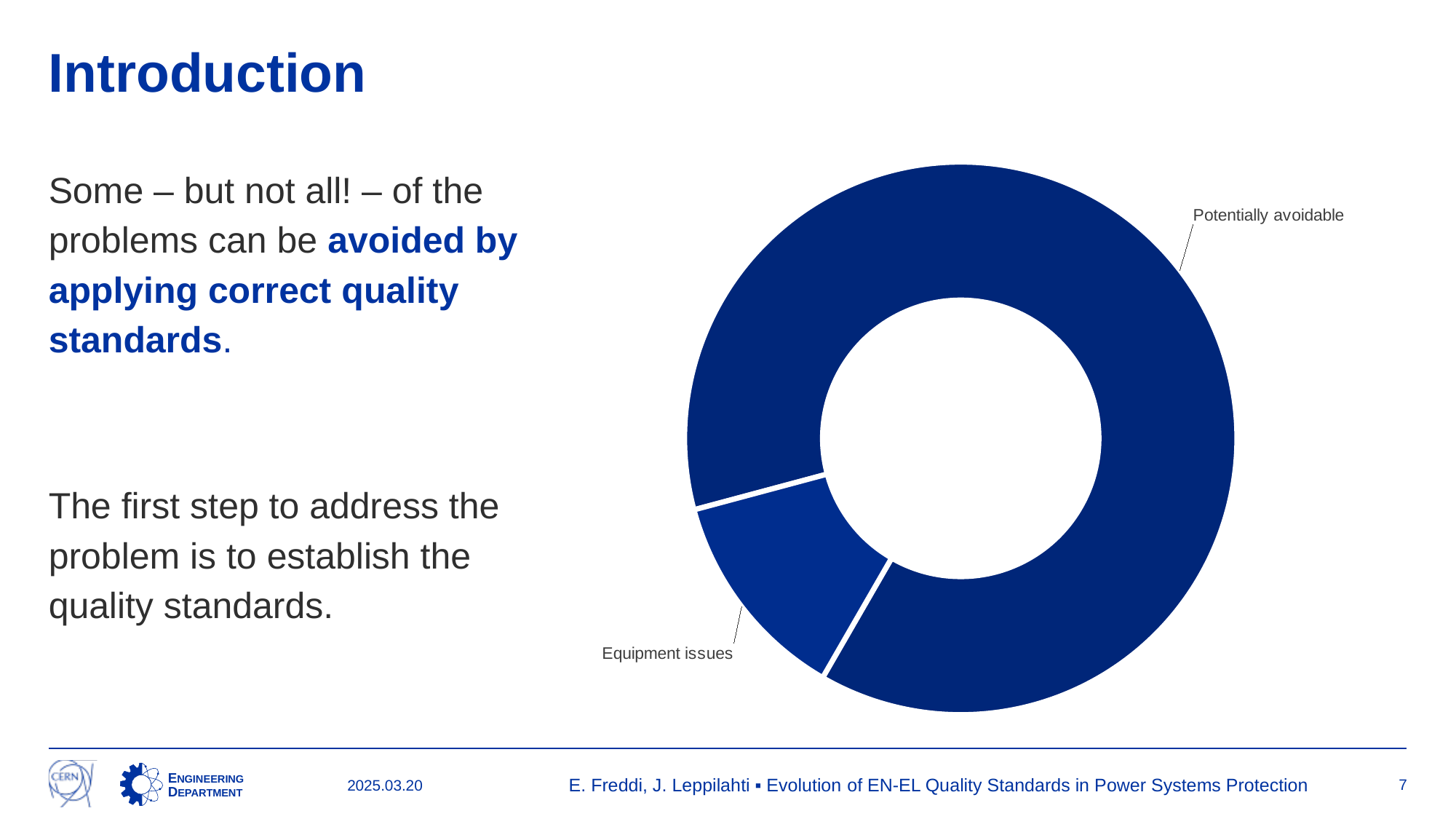
Which slice of the doughnut chart is drawn in the lighter shade of blue? Equipment issues What kind of chart is shown on the slide? Doughnut chart What are the labels of the two slices in the doughnut chart? Potentially avoidable and Equipment issues Is the Equipment issues slice more or less than half of the doughnut chart? less Which slice of the doughnut chart is the largest? Potentially avoidable Which slice of the doughnut chart is the smallest? Equipment issues Which slice is larger, Potentially avoidable or Equipment issues? Potentially avoidable Is the Potentially avoidable slice more or less than half of the doughnut chart? more How many slices does the doughnut chart have? 2